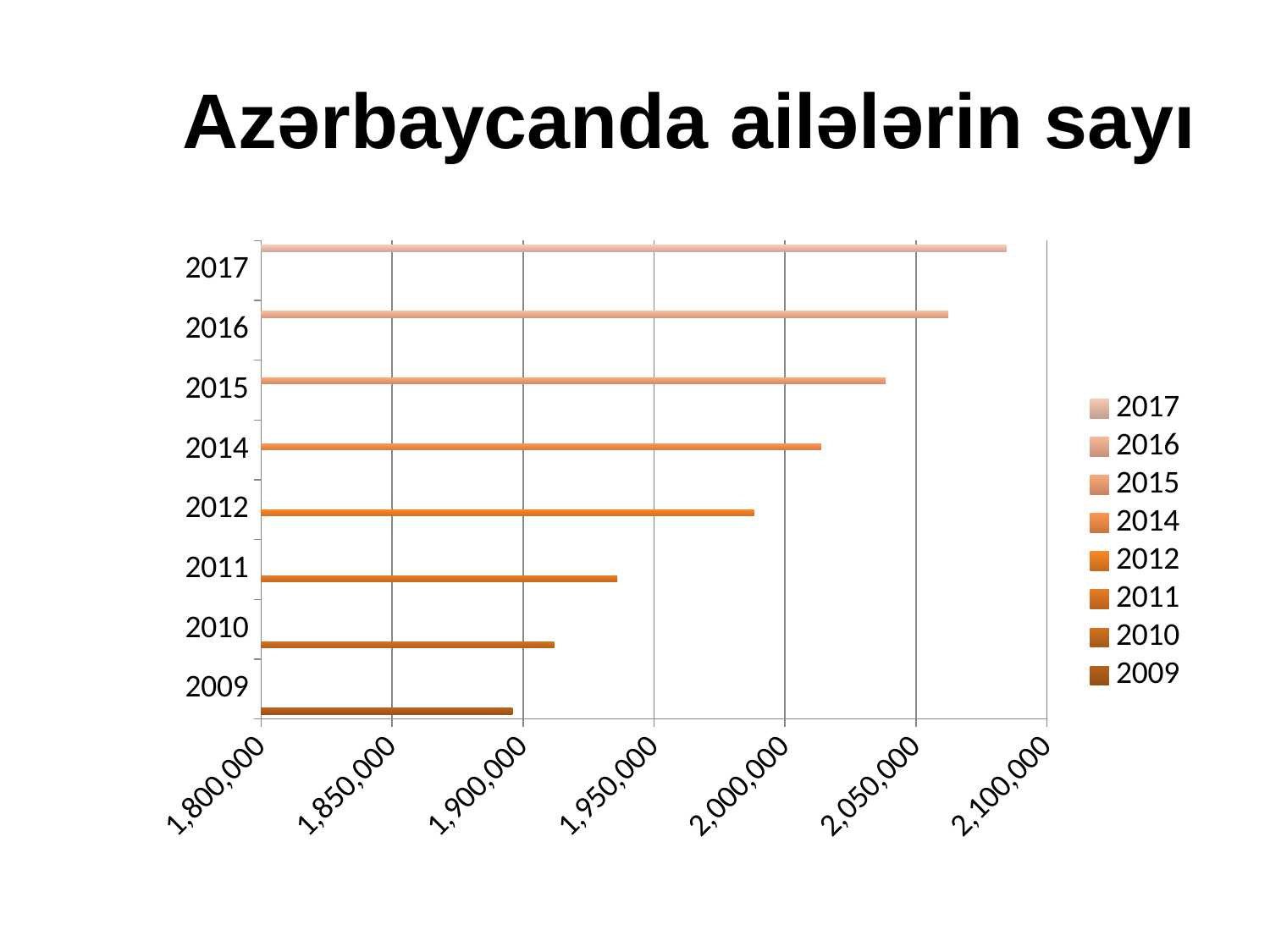
Is the value for 2017 greater or less than 2,050,000? greater Is the value for 2012 greater or less than 2,000,000? less Do the values rise or fall from 2009 to 2017? rise How many bars (years) are plotted in the chart? 8 Which is larger, the value for 2015 or the value for 2011? 2015 How many entries does the legend list? 8 What kind of chart is shown on the slide? bar chart Is the value for 2014 greater or less than 2,000,000? greater Which year has the highest value? 2017 Which year has the lowest value? 2009 What is the title of the slide? Azərbaycanda ailələrin sayı